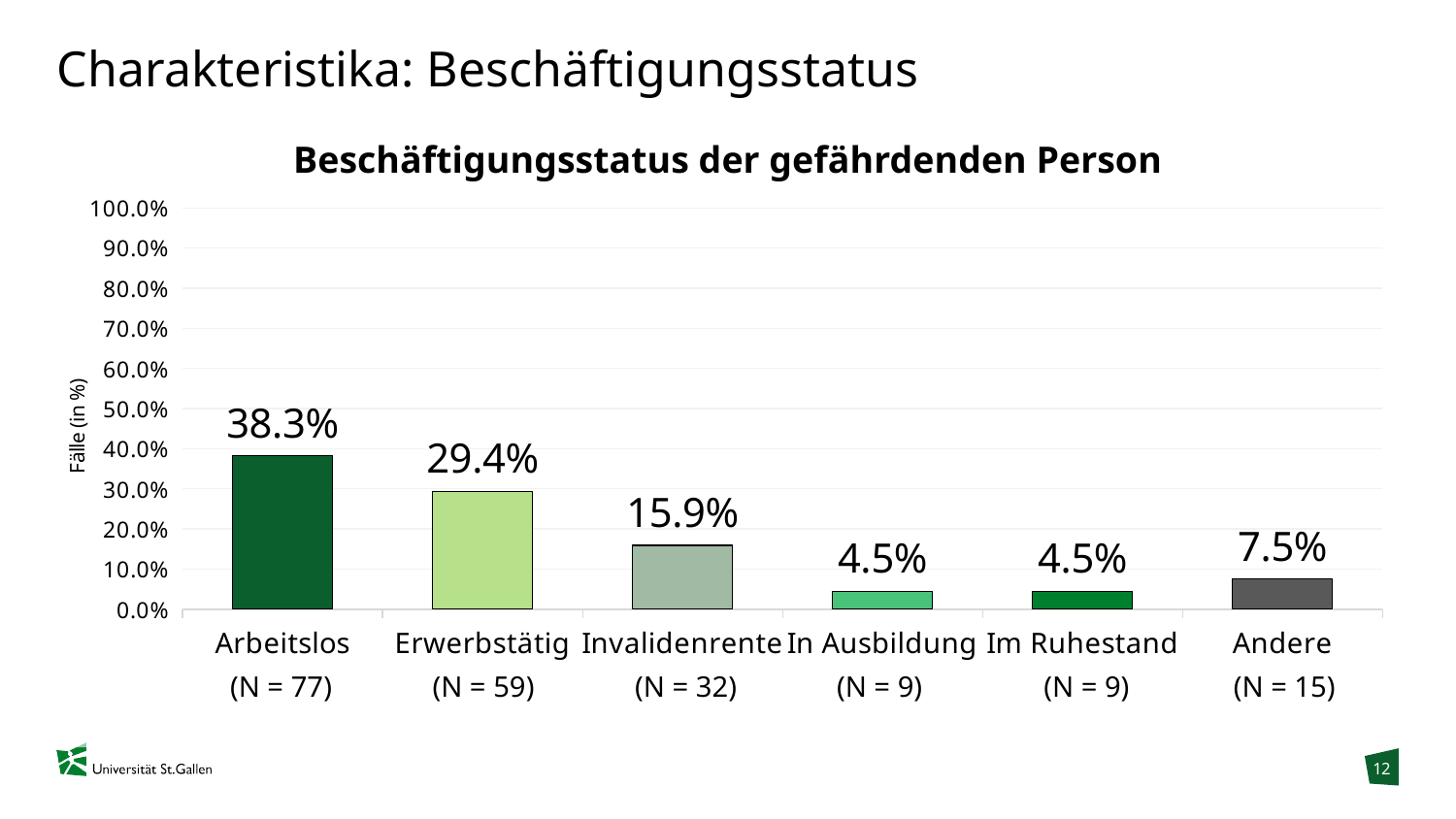
What is the title of the chart? Beschäftigungsstatus der gefährdenden Person What is the difference between the values for Arbeitslos and Erwerbstätig? 8.9% What is the value for Invalidenrente? 15.9% What is the value for Andere? 7.5% Is the value for Erwerbstätig greater or less than 20.0%? greater Which category has the highest value? Arbeitslos How many categories are shown on the x axis? 6 Which is larger, the value for Erwerbstätig or the value for Invalidenrente? Erwerbstätig What kind of chart is shown on the slide? bar chart What is the difference between the values for Invalidenrente and Andere? 8.4% What is the value for Erwerbstätig? 29.4% What is the value for Arbeitslos? 38.3%